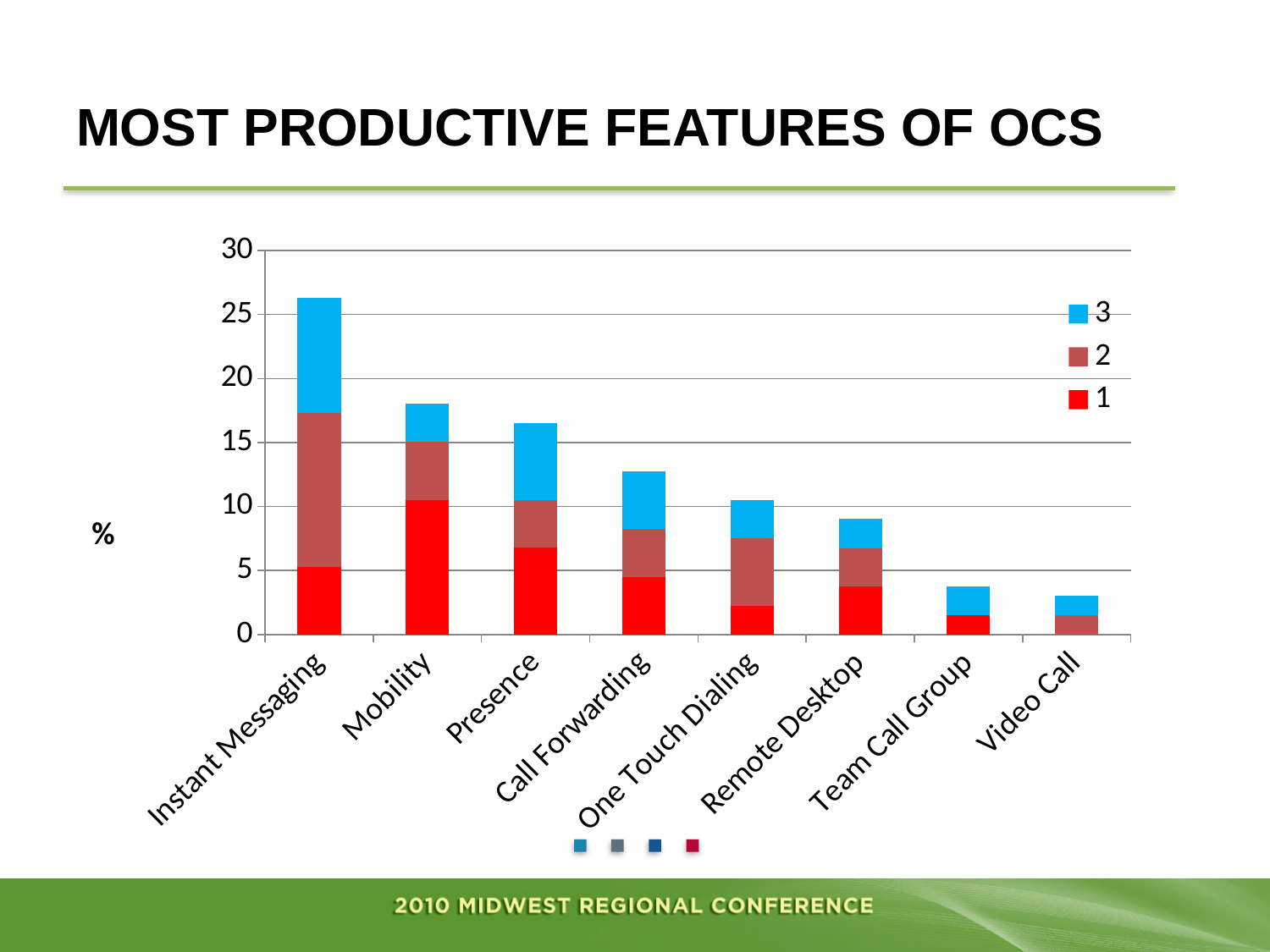
How many series does the legend list? 3 What label is shown on the vertical axis? % Which feature has the highest total bar? Instant Messaging Is the total value for Instant Messaging greater or less than 25? greater What kind of chart is shown on the slide? stacked bar chart Is the total value for Remote Desktop greater or less than 10? less Which has a larger total bar, Mobility or Presence? Mobility Is the value of series 1 for Mobility greater or less than 5? greater How many feature categories are shown on the x axis? 8 Do the total bar heights rise or fall moving from left to right along the x axis? fall